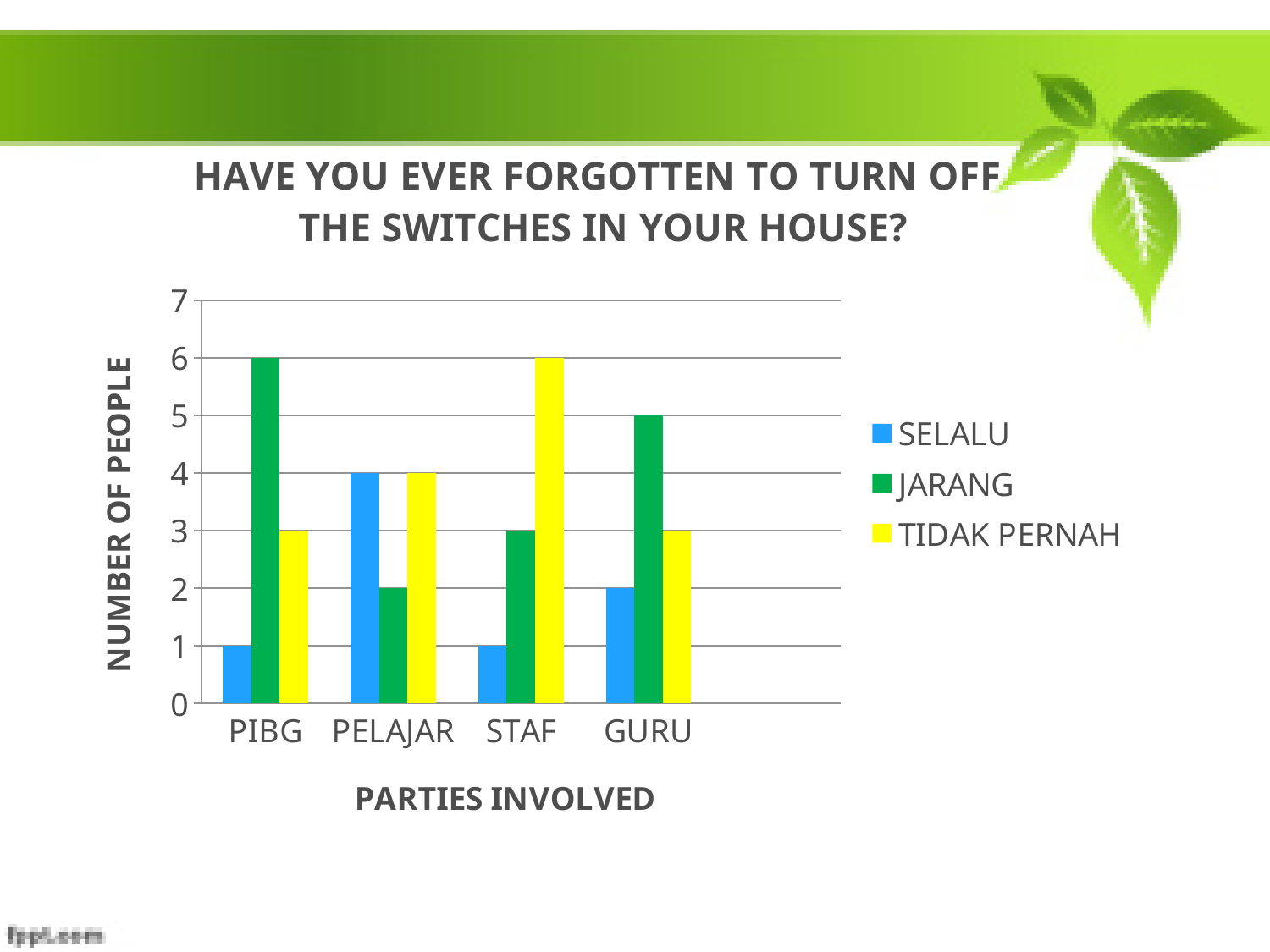
How many categories are shown on the x axis? 4 What is the title of the y axis? NUMBER OF PEOPLE Which colour represents the TIDAK PERNAH series? yellow Which is larger for STAF, the JARANG value or the TIDAK PERNAH value? TIDAK PERNAH What is the SELALU value for PELAJAR? 4 Which category has the lowest JARANG value? PELAJAR What is the difference between the JARANG value for GURU and the SELALU value for GURU? 3 What kind of chart is shown on the slide? bar chart What is the JARANG value for PIBG? 6 What is the TIDAK PERNAH value for STAF? 6 Which category has the highest SELALU value? PELAJAR How many series does the legend list? 3